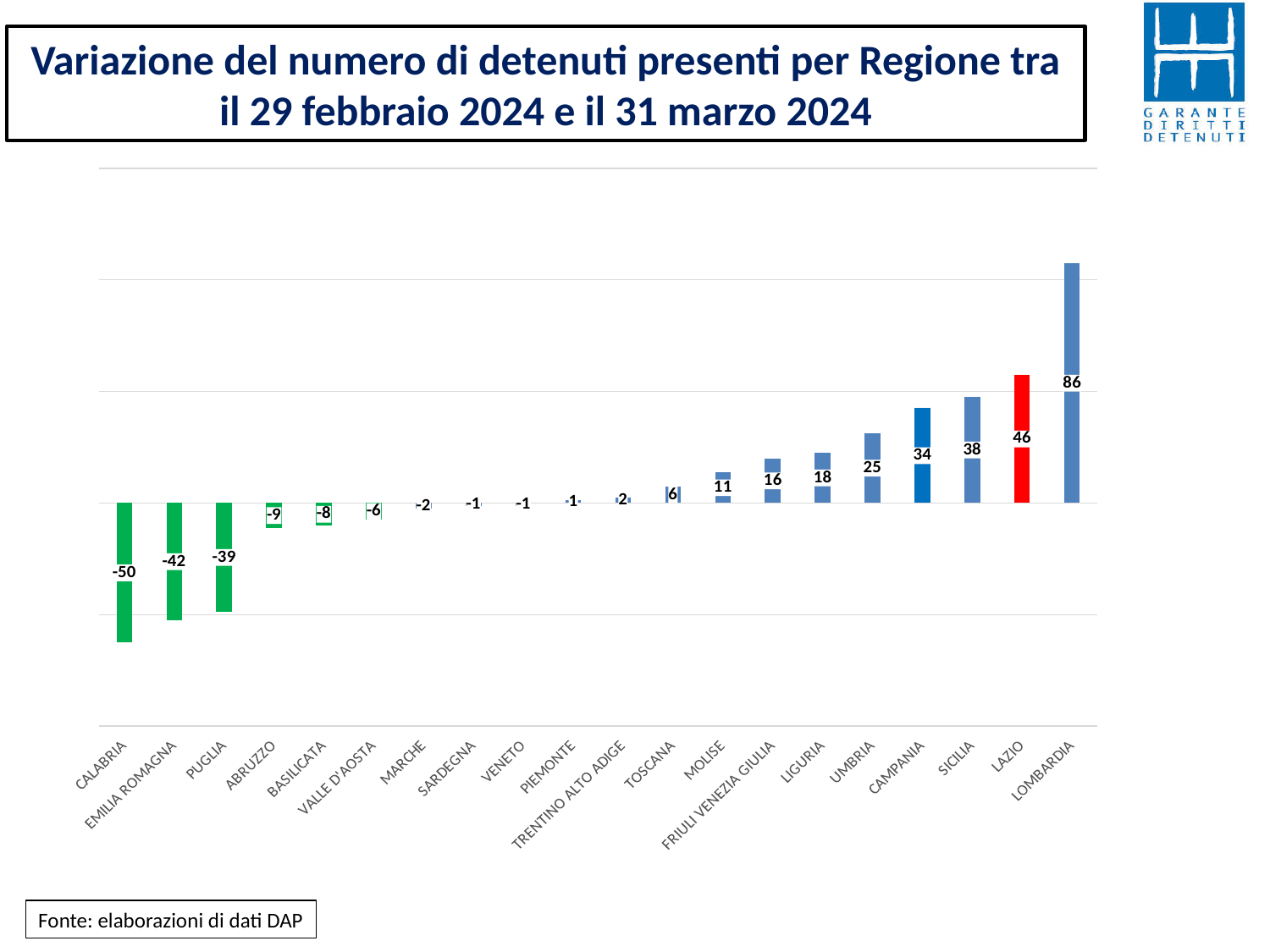
How many regions are shown on the chart? 20 Which is larger, the value for SICILIA or the value for CAMPANIA? SICILIA Which region has the highest value? LOMBARDIA What is the value for UMBRIA? 25 What is the value for LAZIO? 46 What kind of chart is shown on the slide? Bar chart What is the value for CALABRIA? -50 What is the value for LOMBARDIA? 86 What is the difference between the values for LOMBARDIA and LAZIO? 40 What is the difference between the values for EMILIA ROMAGNA and PUGLIA? 3 Which region has the lowest value? CALABRIA Which region's bar is coloured red? LAZIO